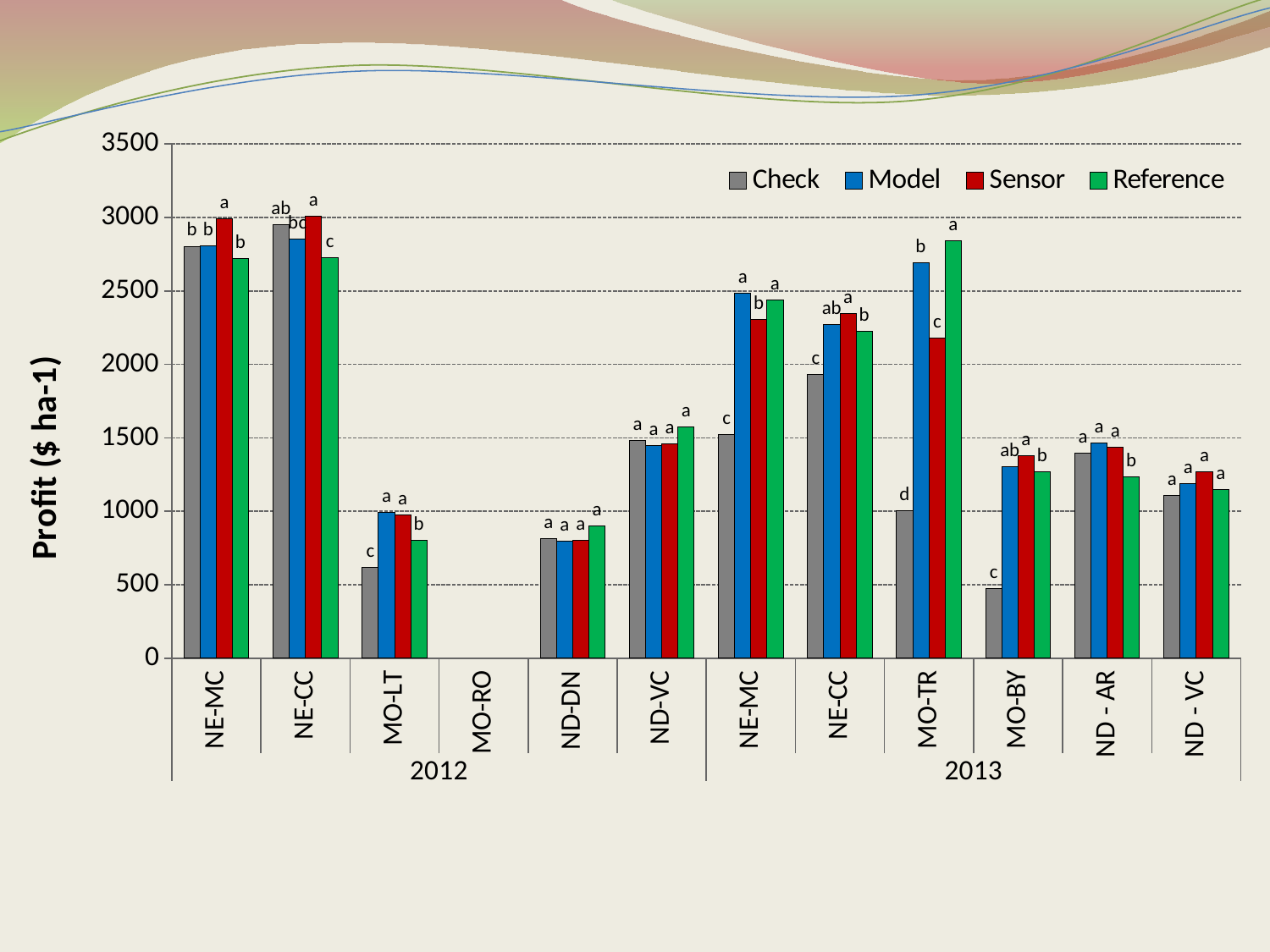
What is the title of the y axis? Profit ($ ha-1) Is the Check value for ND-DN in 2012 greater or less than 1000? less How many site labels are shown along the x axis? 12 For NE-MC in 2012, which is larger, the Sensor value or the Reference value? Sensor For MO-BY in 2013, which series has the lowest bar? Check Which x-axis category has no bars plotted? MO-RO How many series does the legend list? 4 Is the Check value for NE-CC in 2013 greater or less than 2000? less For MO-TR in 2013, which series has the highest bar? Reference What type of chart is shown on the slide? bar chart Is the Model value for MO-TR in 2013 greater or less than 2500? greater